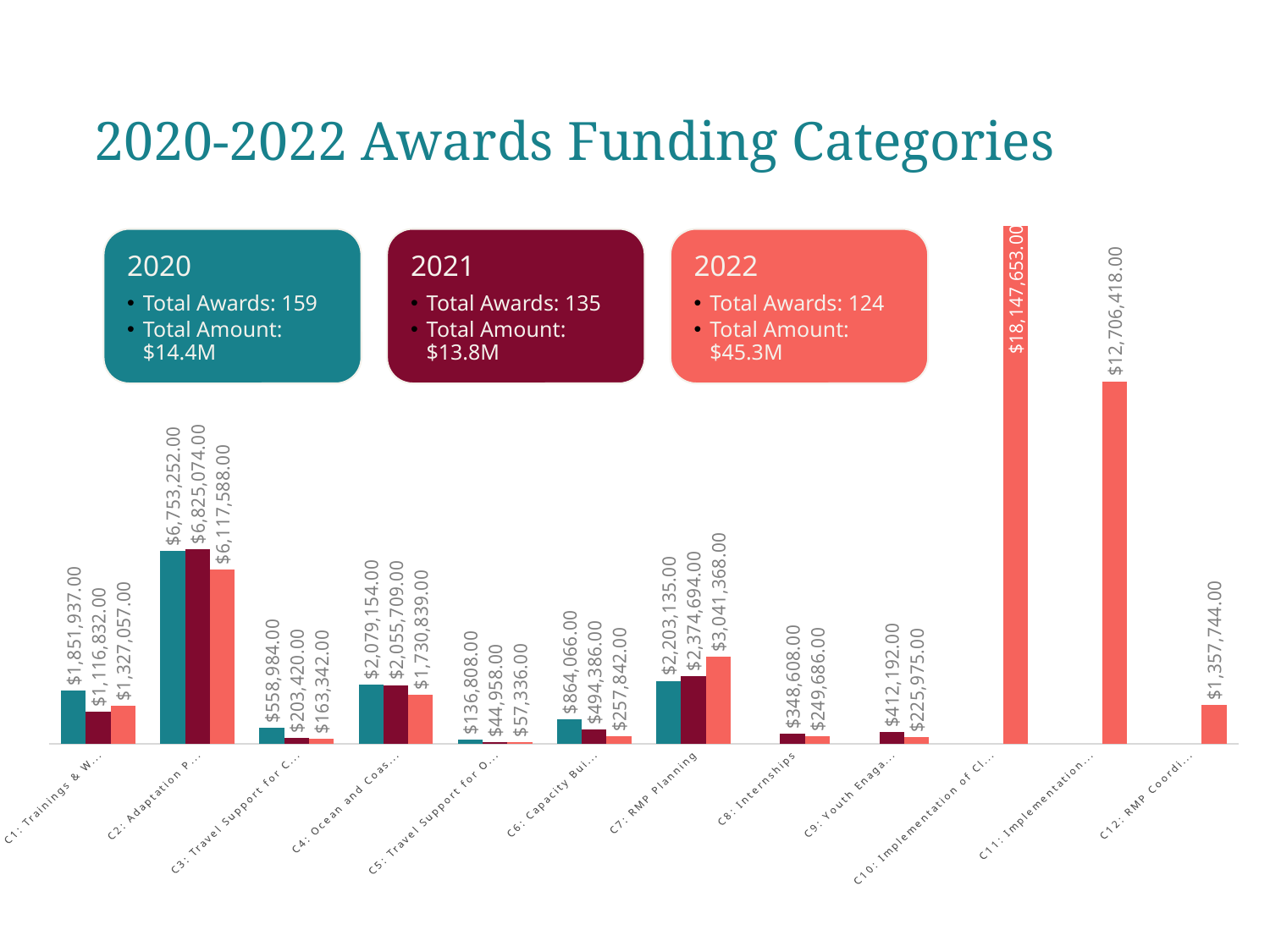
For C2, which year has the larger value, 2020 or 2021? 2021 Which bar has the lowest labelled value in the chart? C5 (2021), $44,958.00 What is the difference between the 2020 and 2021 values for C1? $735,105.00 What is the 2020 value for C1? $1,851,937.00 For C7: RMP Planning, do the values rise or fall from 2020 to 2022? Rise What is the 2021 value for C8: Internships? $348,608.00 What is the difference between the 2022 and 2020 values for C7: RMP Planning? $838,233.00 How many funding categories are shown along the x axis of the chart? 12 What is the title of the slide? 2020-2022 Awards Funding Categories Which bar has the highest value in the chart? C10 (2022), $18,147,653.00 What is the 2022 value for C7: RMP Planning? $3,041,368.00 What type of chart is shown on the slide? Bar chart